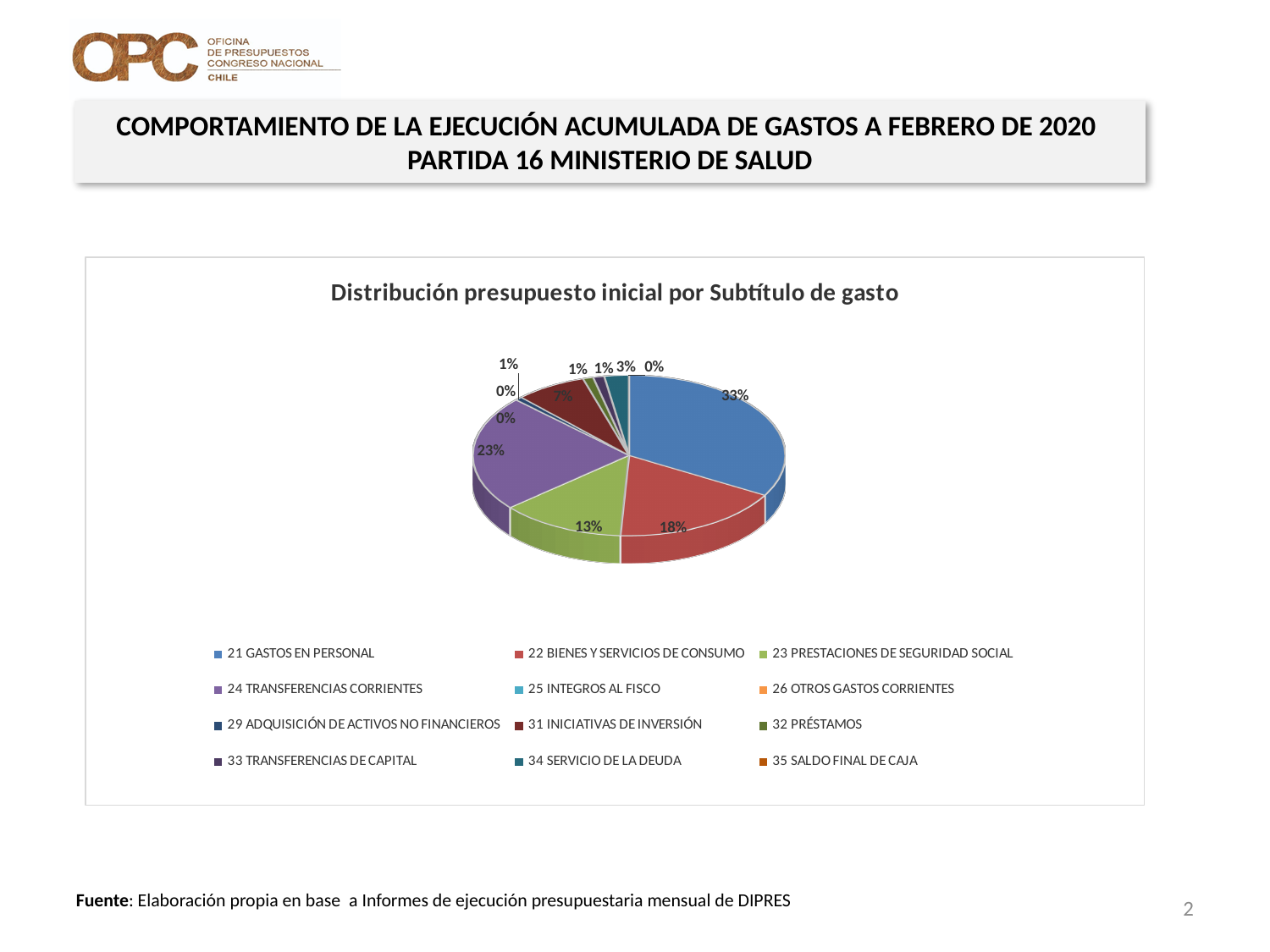
Which category has the largest share of the pie? 21 GASTOS EN PERSONAL Which has a larger share: 24 TRANSFERENCIAS CORRIENTES or 23 PRESTACIONES DE SEGURIDAD SOCIAL? 24 TRANSFERENCIAS CORRIENTES What share of the pie corresponds to 23 PRESTACIONES DE SEGURIDAD SOCIAL? 13% What type of chart is shown on the slide? Pie chart How many categories does the chart's legend list? 12 What share of the pie corresponds to 24 TRANSFERENCIAS CORRIENTES? 23% What is the title of the chart? Distribución presupuesto inicial por Subtítulo de gasto What share of the pie corresponds to 21 GASTOS EN PERSONAL? 33% By how many percentage points does the share of 21 GASTOS EN PERSONAL exceed that of 22 BIENES Y SERVICIOS DE CONSUMO? 15 percentage points What colour is the slice for 21 GASTOS EN PERSONAL? Blue